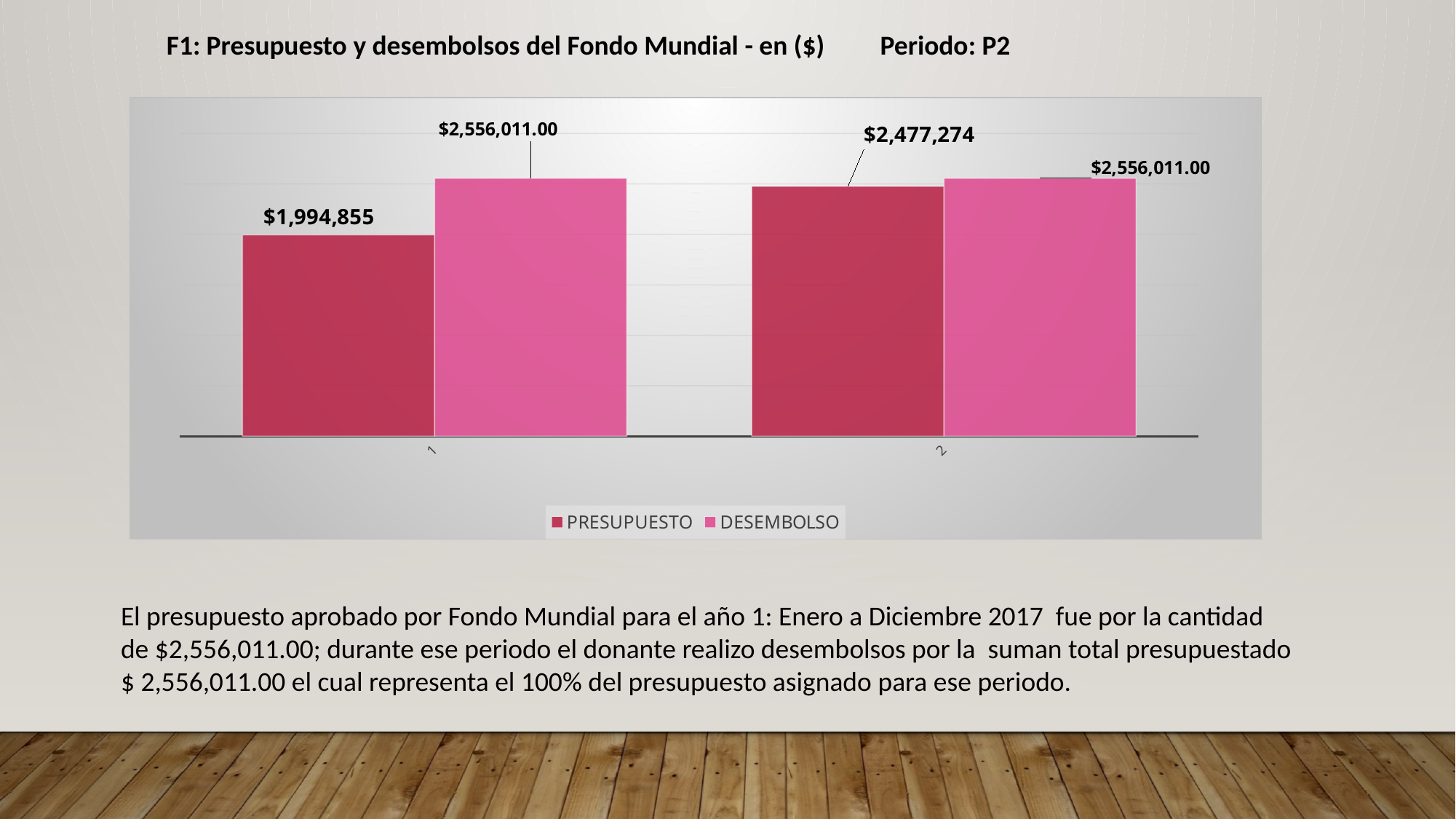
How many series does the legend list? 2 Does the PRESUPUESTO value rise or fall from category 1 to category 2? Rise What is the PRESUPUESTO value for category 1? $1,994,855 What is the difference between DESEMBOLSO and PRESUPUESTO for category 1? $561,156 Which bar in the chart has the lowest value? PRESUPUESTO for category 1 What is the DESEMBOLSO value for category 1? $2,556,011.00 What is the PRESUPUESTO value for category 2? $2,477,274 What is the DESEMBOLSO value for category 2? $2,556,011.00 What is the difference between DESEMBOLSO and PRESUPUESTO for category 2? $78,737 What kind of chart is shown on the slide? Bar chart For category 1, which is larger: PRESUPUESTO or DESEMBOLSO? DESEMBOLSO Which category has the higher PRESUPUESTO value? 2